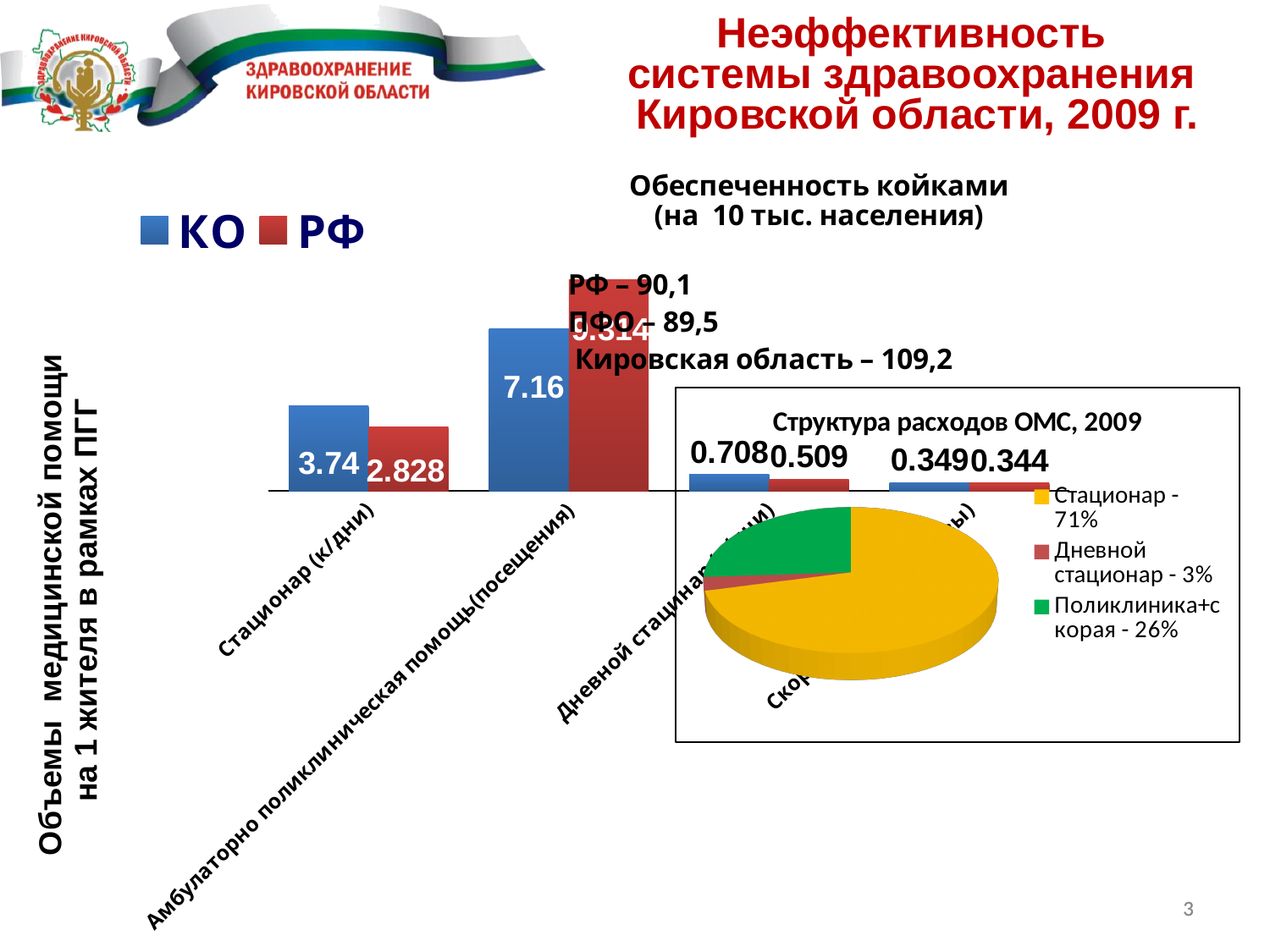
In the bar chart with the KO and РФ legend, which category has the highest KO value? Амбулаторно поликлиническая помощь (посещения) What kind of chart is the chart titled Структура расходов ОМС, 2009? Pie chart In the pie chart Структура расходов ОМС, 2009, what share does Поликлиника+скорая have? 26% In the pie chart Структура расходов ОМС, 2009, what share does Стационар have? 71% In the bar chart with the KO and РФ legend, what is the РФ value for Стационар (к/дни)? 2.828 In the bar chart with the KO and РФ legend, what is the difference between the KO and РФ values for Стационар (к/дни)? 0.912 In the bar chart with the KO and РФ legend, which is larger for Стационар (к/дни): KO or РФ? KO In the bar chart with the KO and РФ legend, how many series does the legend list? 2 In the pie chart Структура расходов ОМС, 2009, which slice is the smallest? Дневной стационар - 3% In the bar chart with the KO and РФ legend, what is the KO value for Стационар (к/дни)? 3.74 In the bar chart with the KO and РФ legend, what is the KO value for Амбулаторно поликлиническая помощь (посещения)? 7.16 In the bar chart with the KO and РФ legend, which is larger for Амбулаторно поликлиническая помощь (посещения): KO or РФ? РФ